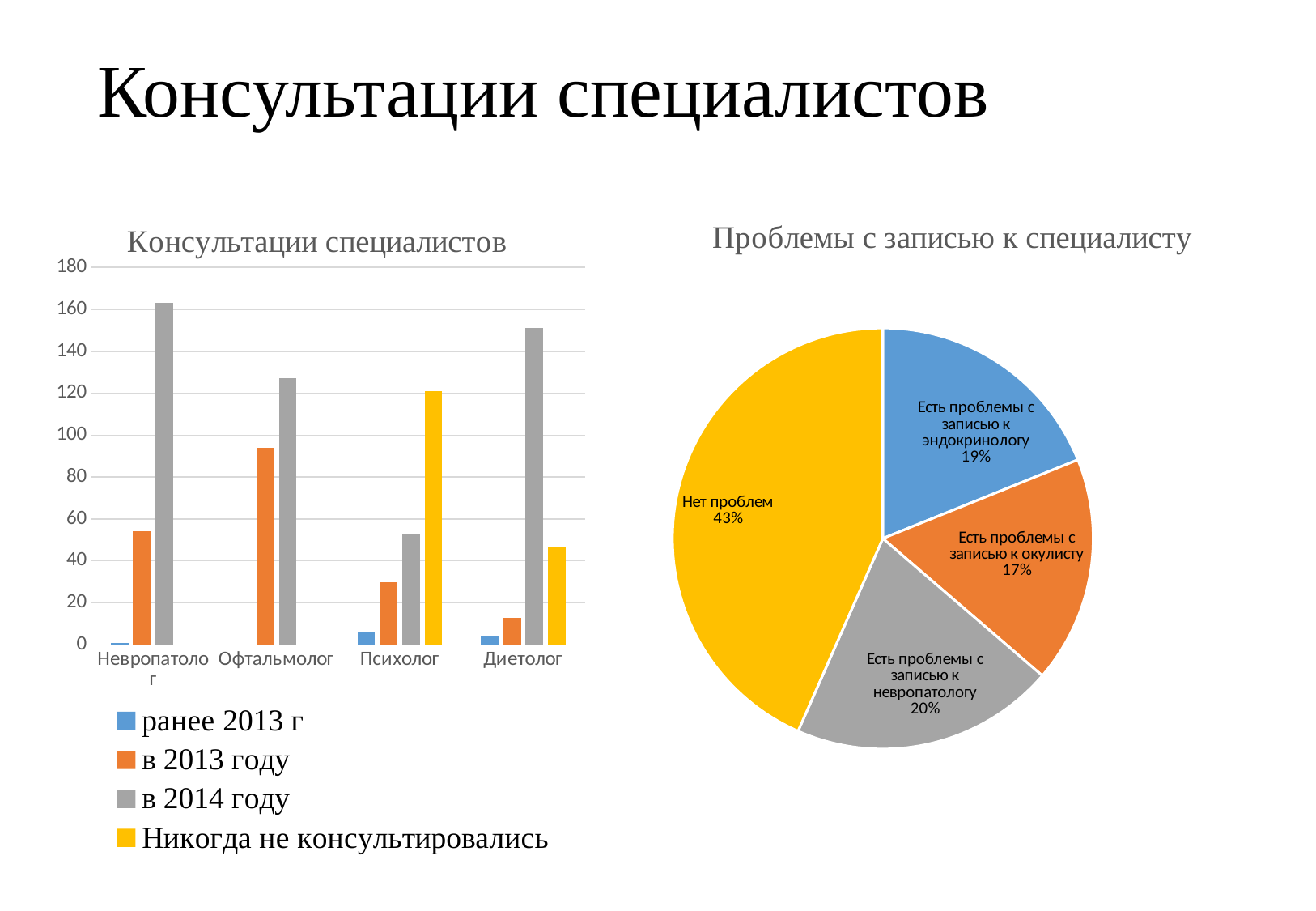
In the pie chart 'Проблемы с записью к специалисту', how many percentage points larger is 'Нет проблем' than 'Есть проблемы с записью к невропатологу'? 23 What type of chart is 'Консультации специалистов' on the left of the slide? Bar chart How many series does the legend of the bar chart 'Консультации специалистов' list? 4 In the pie chart 'Проблемы с записью к специалисту', which slice is the smallest? Есть проблемы с записью к окулисту In the bar chart 'Консультации специалистов', is the value for 'в 2014 году' for Невропатолог greater or less than 140? greater In the pie chart 'Проблемы с записью к специалисту', which is larger: the slice for эндокринолог or the slice for окулист? Есть проблемы с записью к эндокринологу In the pie chart 'Проблемы с записью к специалисту', what share is labelled 'Нет проблем'? 43% In the bar chart 'Консультации специалистов', is the value for 'в 2014 году' for Психолог greater or less than 60? less In the pie chart 'Проблемы с записью к специалисту', which slice is the largest? Нет проблем In the bar chart 'Консультации специалистов', which series has the tallest bar for Психолог? Никогда не консультировались In the pie chart 'Проблемы с записью к специалисту', what percentage is shown for 'Есть проблемы с записью к окулисту'? 17% How many slices does the pie chart 'Проблемы с записью к специалисту' have? 4